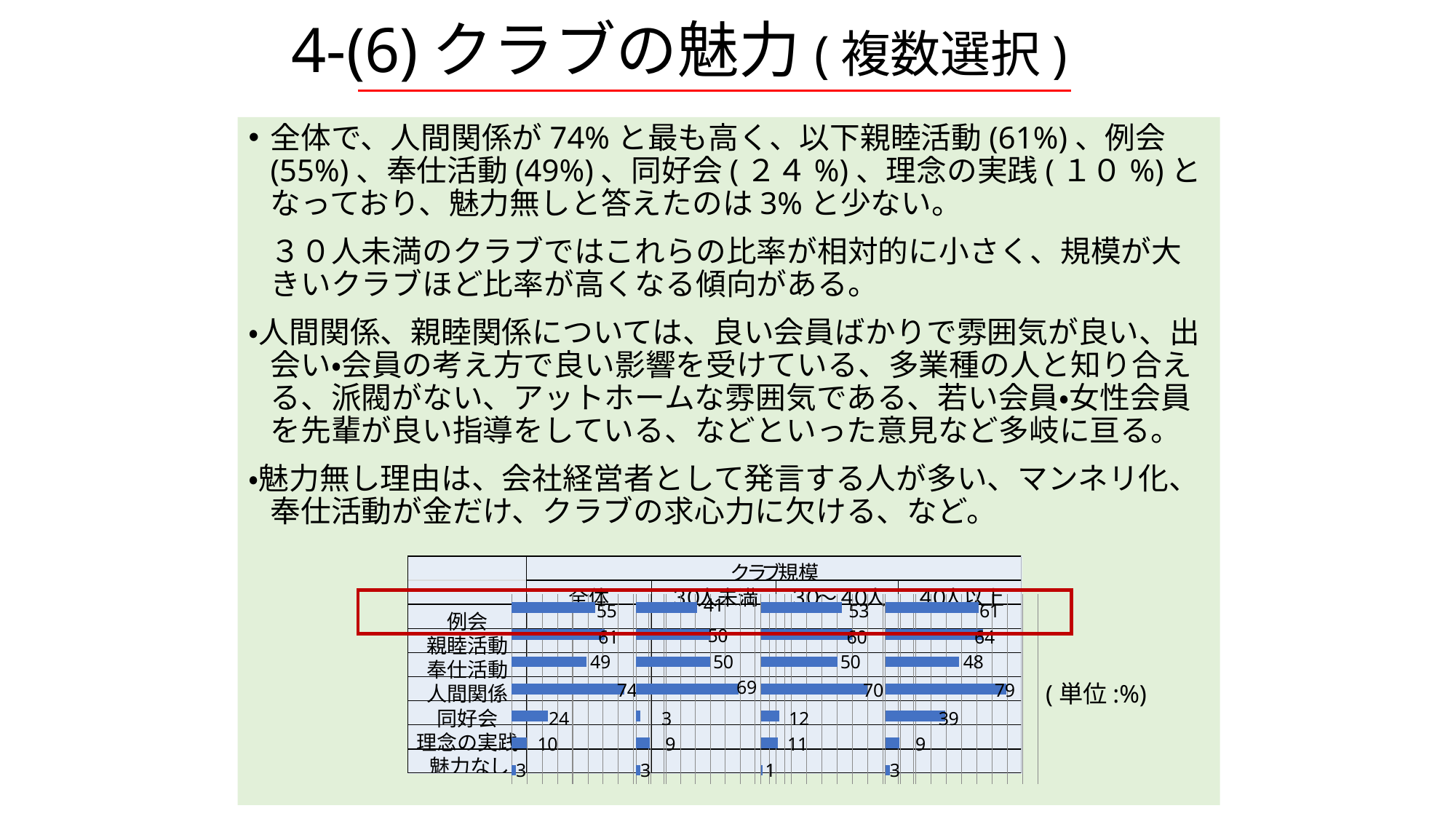
What is the difference between the 40人以上 and 30人未満 values for 同好会? 36 What is the value for 人間関係 in the 全体 column? 74 How many categories (rows) are plotted in the chart? 7 Which is larger for 親睦活動: the 全体 value or the 30人未満 value? 全体 What is the value for 同好会 in the 40人以上 column? 39 What kind of chart is shown on the slide? bar chart Which category has the lowest value in the 30～40人 column? 魅力なし What unit is indicated next to the chart? % What is the value for 魅力なし in the 30～40人 column? 1 Which category has the highest value in the 全体 column? 人間関係 How many club-size columns does the chart show? 4 What is the value for 例会 in the 30人未満 column? 41